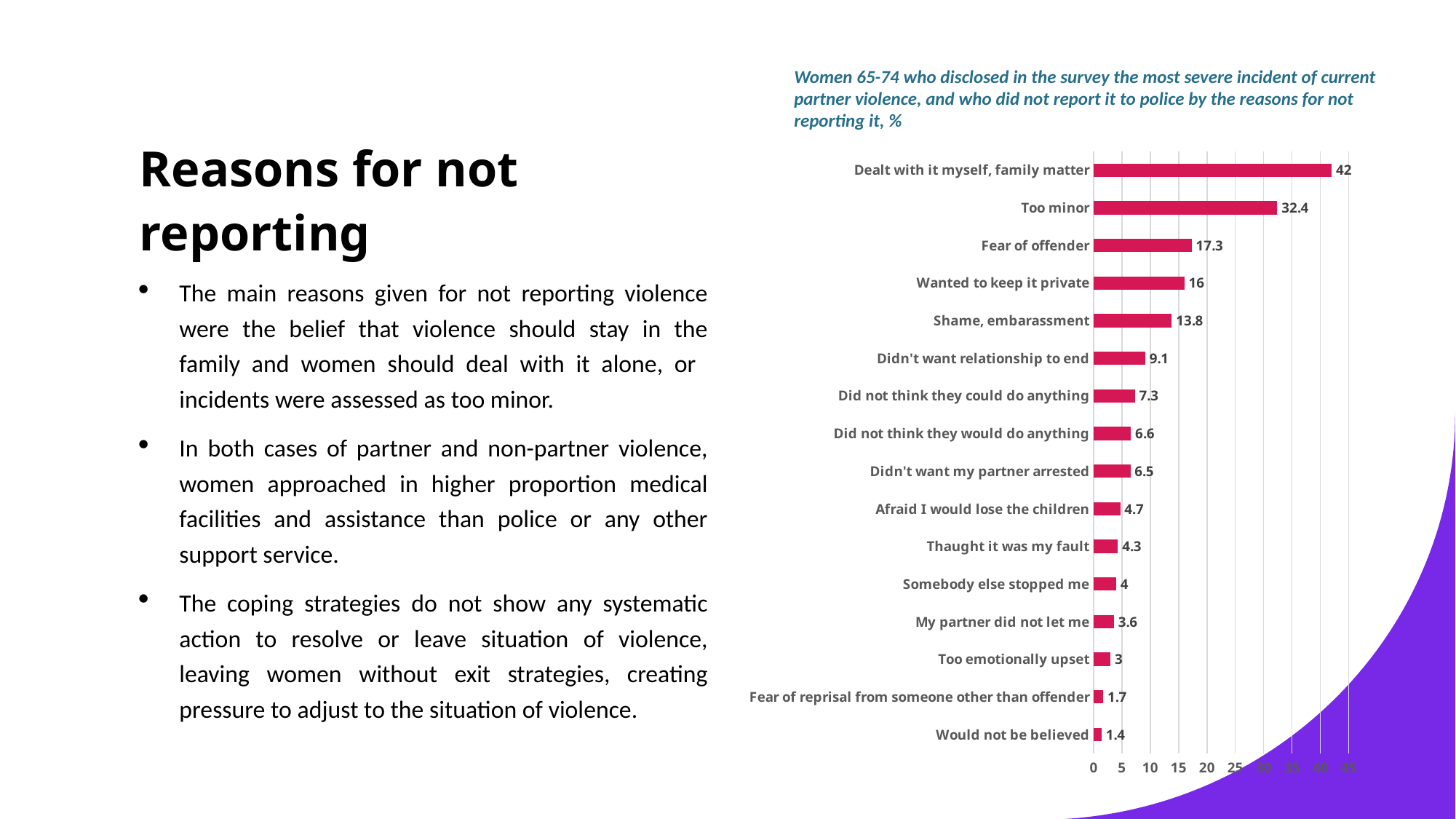
Which reason has the lowest value? Would not be believed What is the value for "Shame, embarassment"? 13.8 What is the value for "Fear of offender"? 17.3 What is the value for "My partner did not let me"? 3.6 How many reasons (categories) are shown in the chart? 16 What kind of chart is shown on the slide? Bar chart Is the value for "Too minor" greater or less than 30? greater Which is larger, the value for "Wanted to keep it private" or the value for "Didn't want relationship to end"? Wanted to keep it private What is the difference between the values for "Afraid I would lose the children" and "Thaught it was my fault"? 0.4 What is the value for "Dealt with it myself, family matter"? 42 Which reason has the highest value? Dealt with it myself, family matter What is the difference between the values for "Dealt with it myself, family matter" and "Too minor"? 9.6